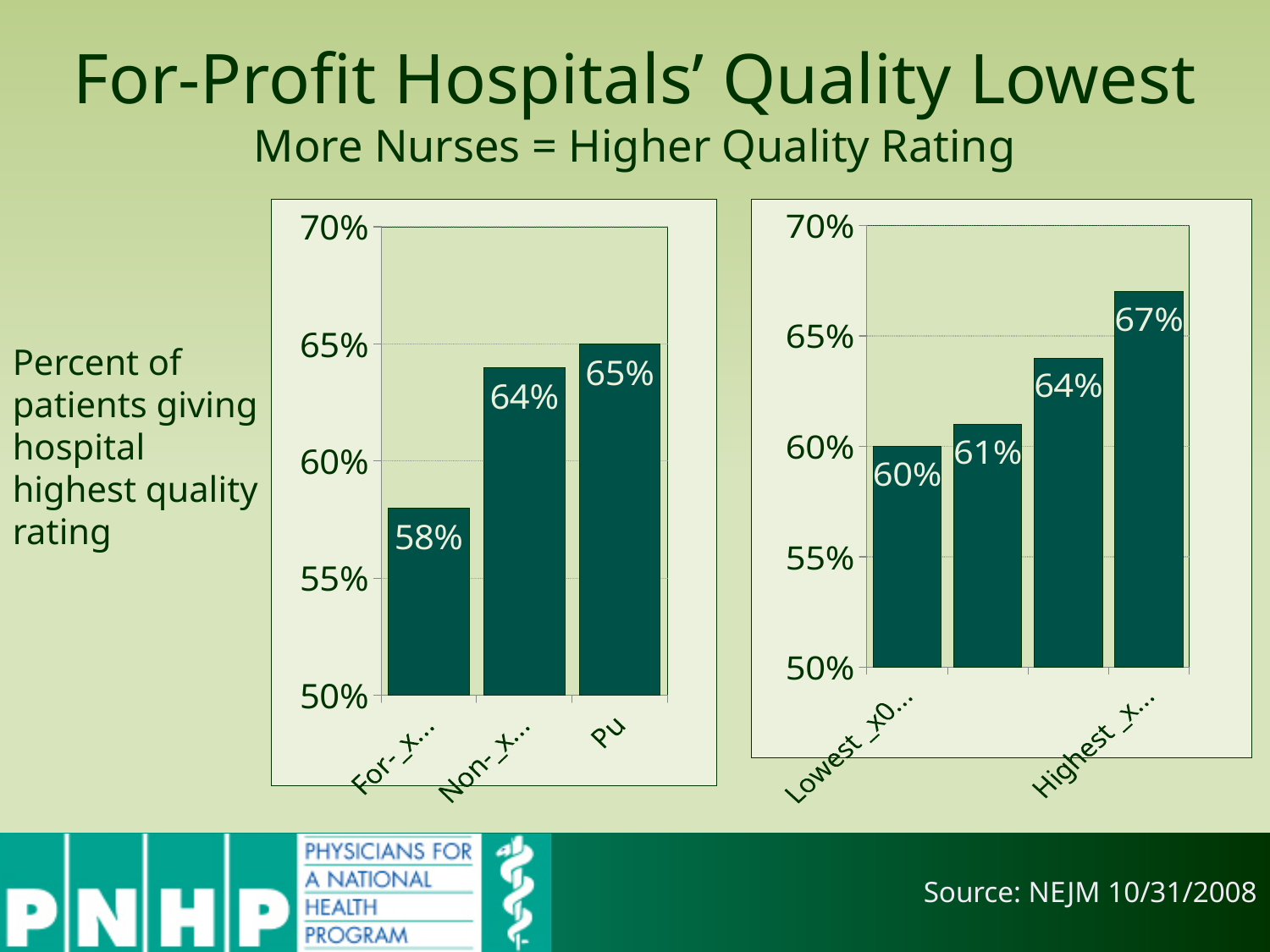
In the left chart, which bar has the highest value? Pu How many bars are in the left chart? 3 In the left chart, what is the value of the leftmost bar? 58% In the left chart, what is the difference between the "Pu" bar and the leftmost bar? 7 percentage points In the left chart, what is the value of the middle bar? 64% How many bars are in the right chart? 4 What type of chart is shown on the right side of the slide? bar chart In the right chart, what is the value of the second bar from the left? 61% In the left chart, what is the lowest value shown? 58% In the right chart, what is the value of the rightmost bar? 67% In the left chart, what is the value of the bar labeled "Pu"? 65% In the right chart, do the values rise or fall from left to right? rise